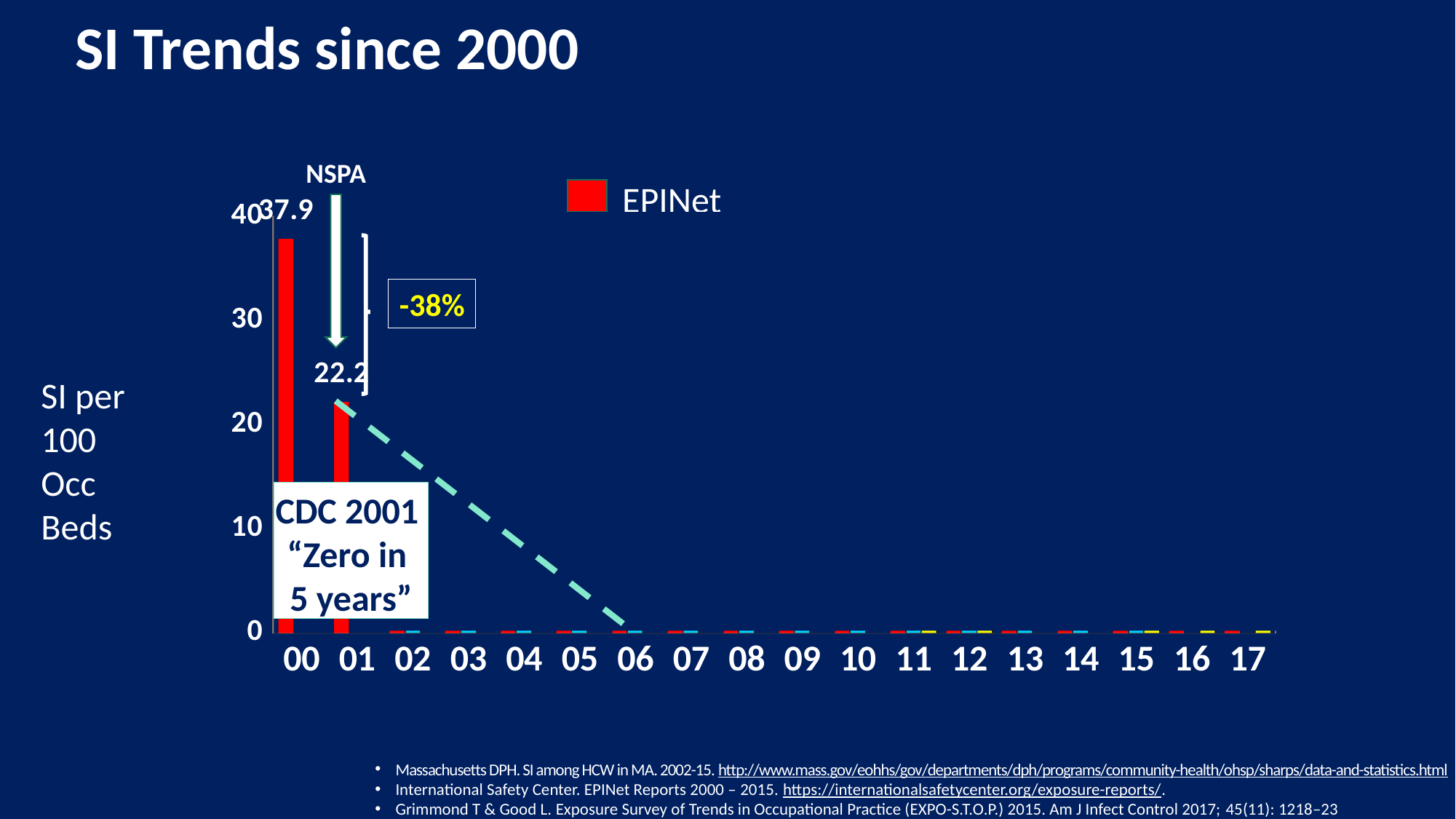
Which year has the highest value in the chart? 00 What percentage change is annotated between the 00 and 01 bars? -38% How many series does the legend list? 1 What is the value for 01 in the chart? 22.2 Which year has the larger value, 00 or 01? 00 How many years are shown on the x axis of the chart? 18 Is the value for 00 greater or less than 30? greater Is the value for 01 greater or less than 30? less What is the value for 00 in the chart? 37.9 Does the value rise or fall from 00 to 01? fall What is the difference between the values for 00 and 01? 15.7 What kind of chart is shown on the slide? bar chart